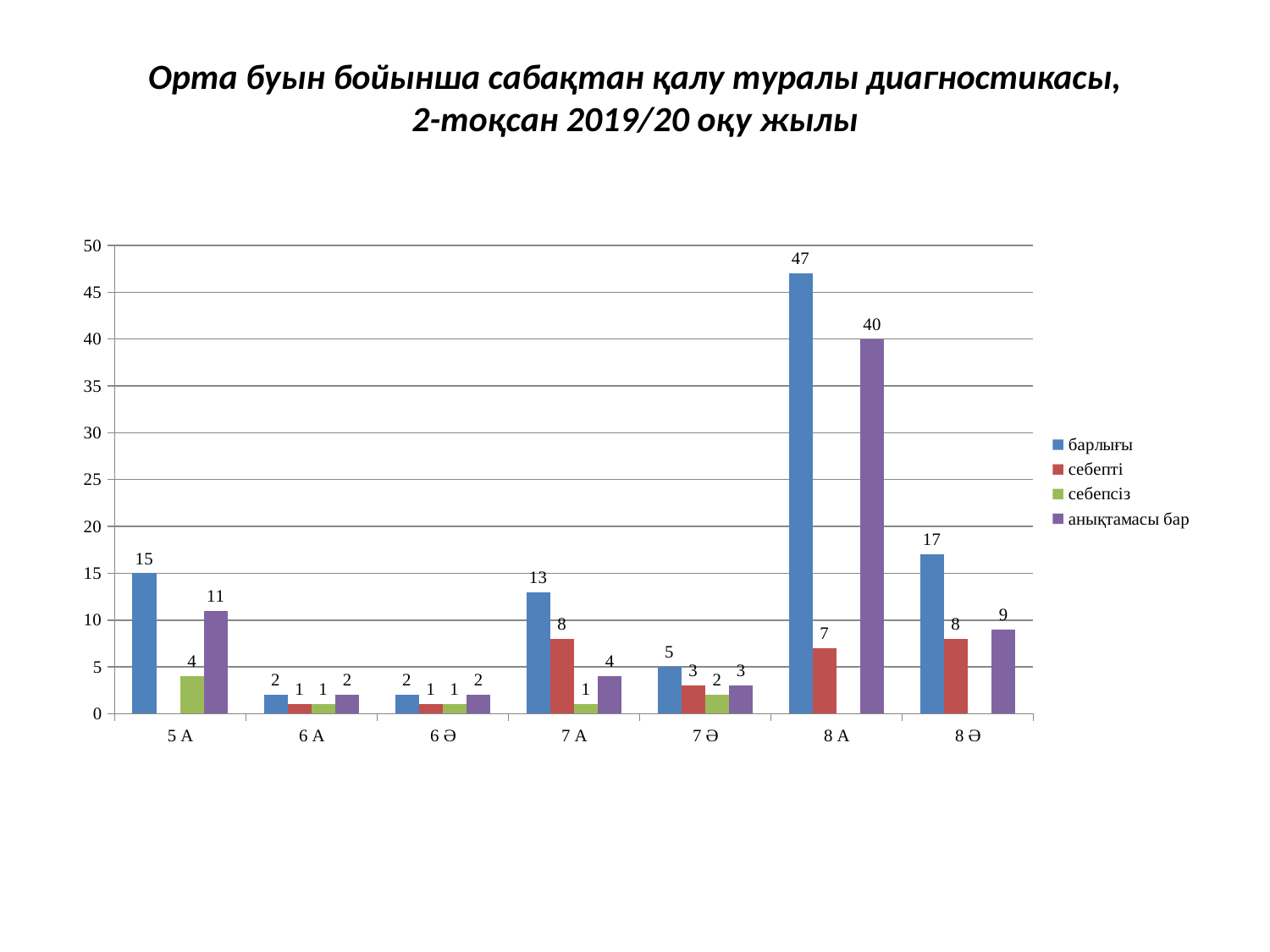
What is the value of барлығы for 8 А? 47 Which class has the lowest анықтамасы бар value? 6 А and 6 Ә What is the difference between барлығы and анықтамасы бар for 8 А? 7 What type of chart is shown on the slide? bar chart How many classes are shown on the x axis? 7 What is the value of себепті for 7 А? 8 Which colour represents the series анықтамасы бар? purple Which is larger for 8 Ә: себепті or анықтамасы бар? анықтамасы бар What is the value of себепсіз for 7 Ә? 2 What is the value of анықтамасы бар for 5 А? 11 Which class has the highest барлығы value? 8 А How many series does the legend list? 4